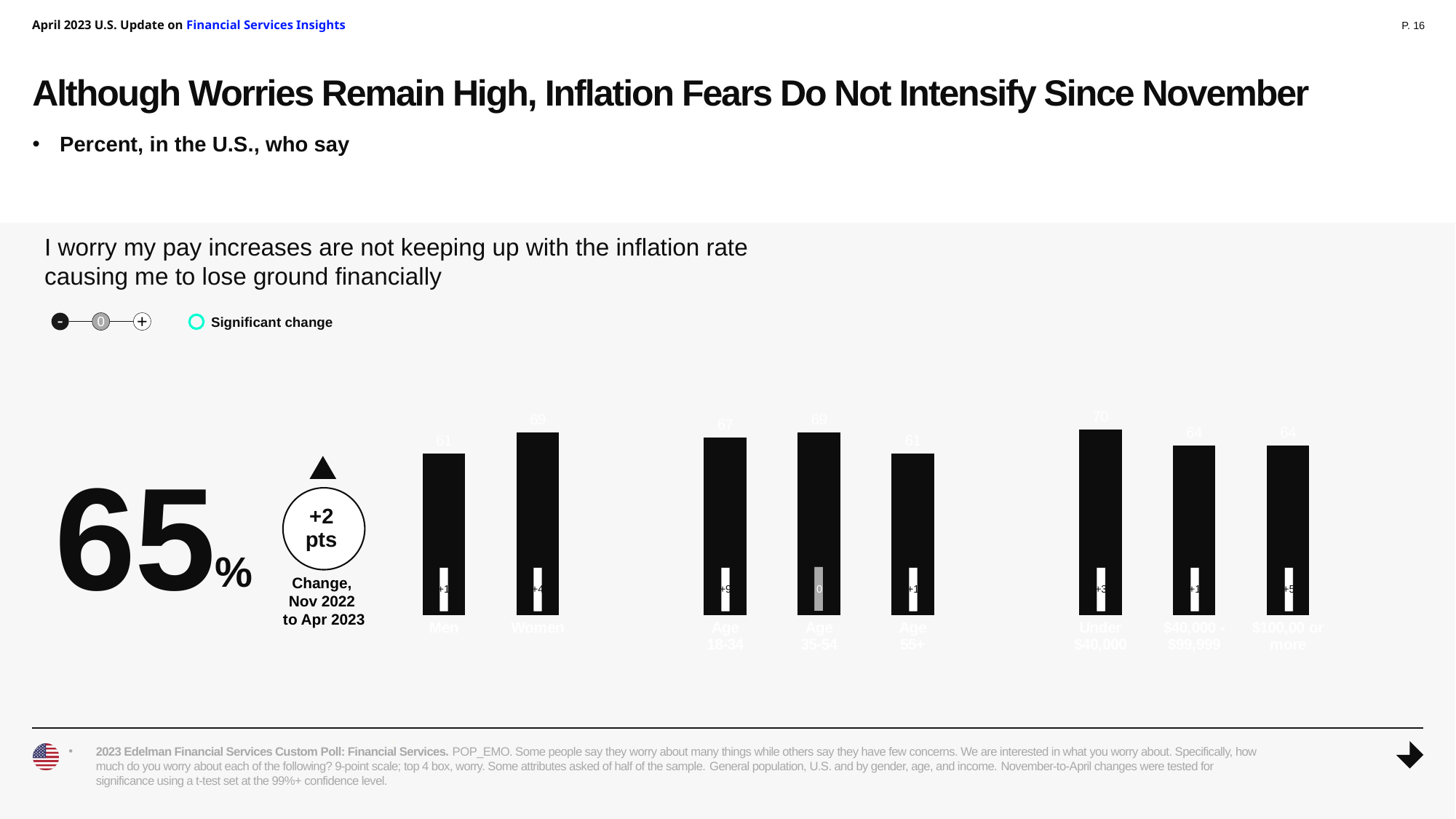
What is the change from Nov 2022 to Apr 2023 in the overall percentage shown? +2 pts What is the value for Women in the bar chart? 69 What percentage of U.S. respondents say they worry their pay increases are not keeping up with the inflation rate? 65% What does the teal circle in the legend indicate? Significant change Which is larger, the value for Age 35-54 or the value for Age 55+? Age 35-54 What is the Nov 2022 to Apr 2023 change shown for Age 18-34? +9 What is the difference between the values for Women and Men? 8 Which group has the highest value in the bar chart? Under $40,000 What kind of chart is used to show the breakdown by gender, age and income? Bar chart What is the value for Men in the bar chart? 61 How many bars are shown in the bar chart? 8 What is the value for Age 18-34? 67